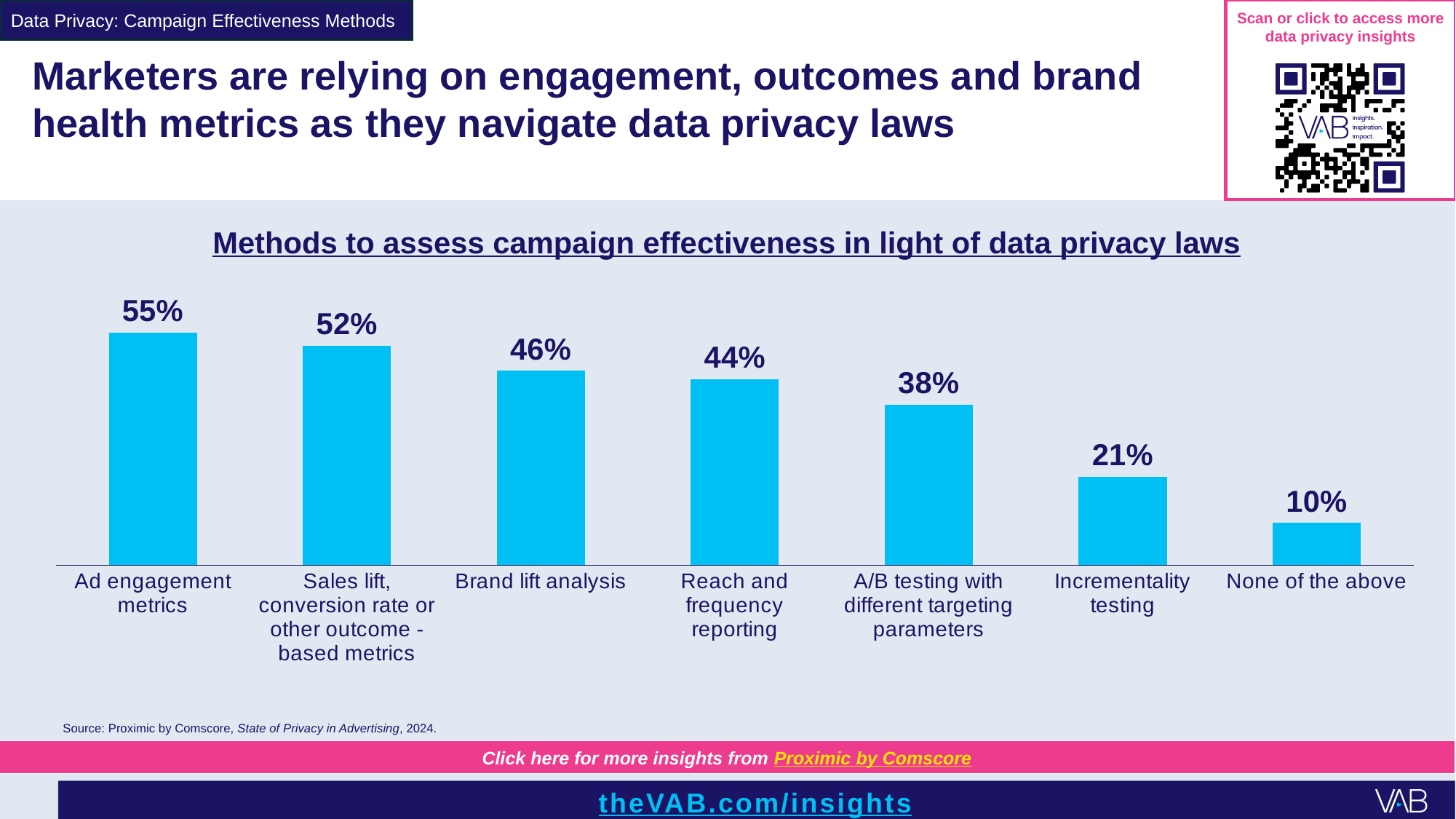
What is the value for A/B testing with different targeting parameters? 38% Which category has the lowest percentage? None of the above Which method has the highest percentage? Ad engagement metrics What type of chart is shown on the slide? Bar chart Which is larger: the value for sales lift, conversion rate or other outcome-based metrics, or the value for brand lift analysis? Sales lift, conversion rate or other outcome-based metrics What is the title of the chart? Methods to assess campaign effectiveness in light of data privacy laws What percentage is shown for incrementality testing? 21% What percentage of marketers use ad engagement metrics to assess campaign effectiveness? 55% What is the value shown for brand lift analysis? 46% What is the difference between the values for A/B testing with different targeting parameters and incrementality testing? 17 percentage points How many categories are shown in the chart? 7 What is the difference between the values for ad engagement metrics and reach and frequency reporting? 11 percentage points